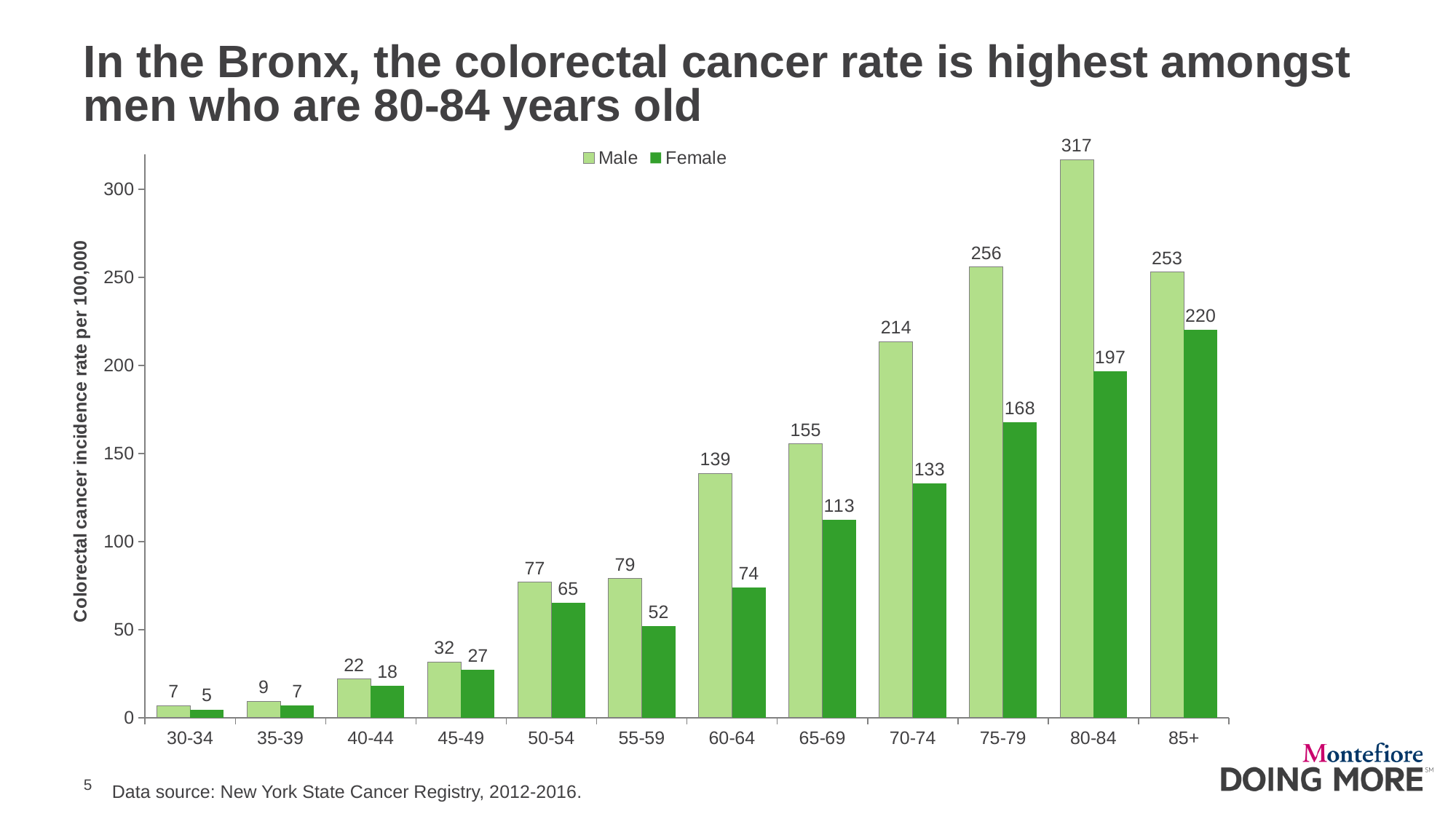
How many series does the legend list? 2 Which age group has the lowest male colorectal cancer incidence rate? 30-34 What is the label of the y axis? Colorectal cancer incidence rate per 100,000 What is the male colorectal cancer incidence rate for the 80-84 age group? 317 Which is larger in the 45-49 age group, the male rate or the female rate? Male Which age group has the highest female colorectal cancer incidence rate? 85+ What is the female colorectal cancer incidence rate for the 65-69 age group? 113 Do the female rates generally rise or fall from the 30-34 age group to the 85+ age group? Rise How many age groups are shown on the x axis? 12 Is the male rate for the 70-74 age group greater or less than 200? greater What is the difference between the male and female rates in the 80-84 age group? 120 What kind of chart is shown on the slide? Bar chart